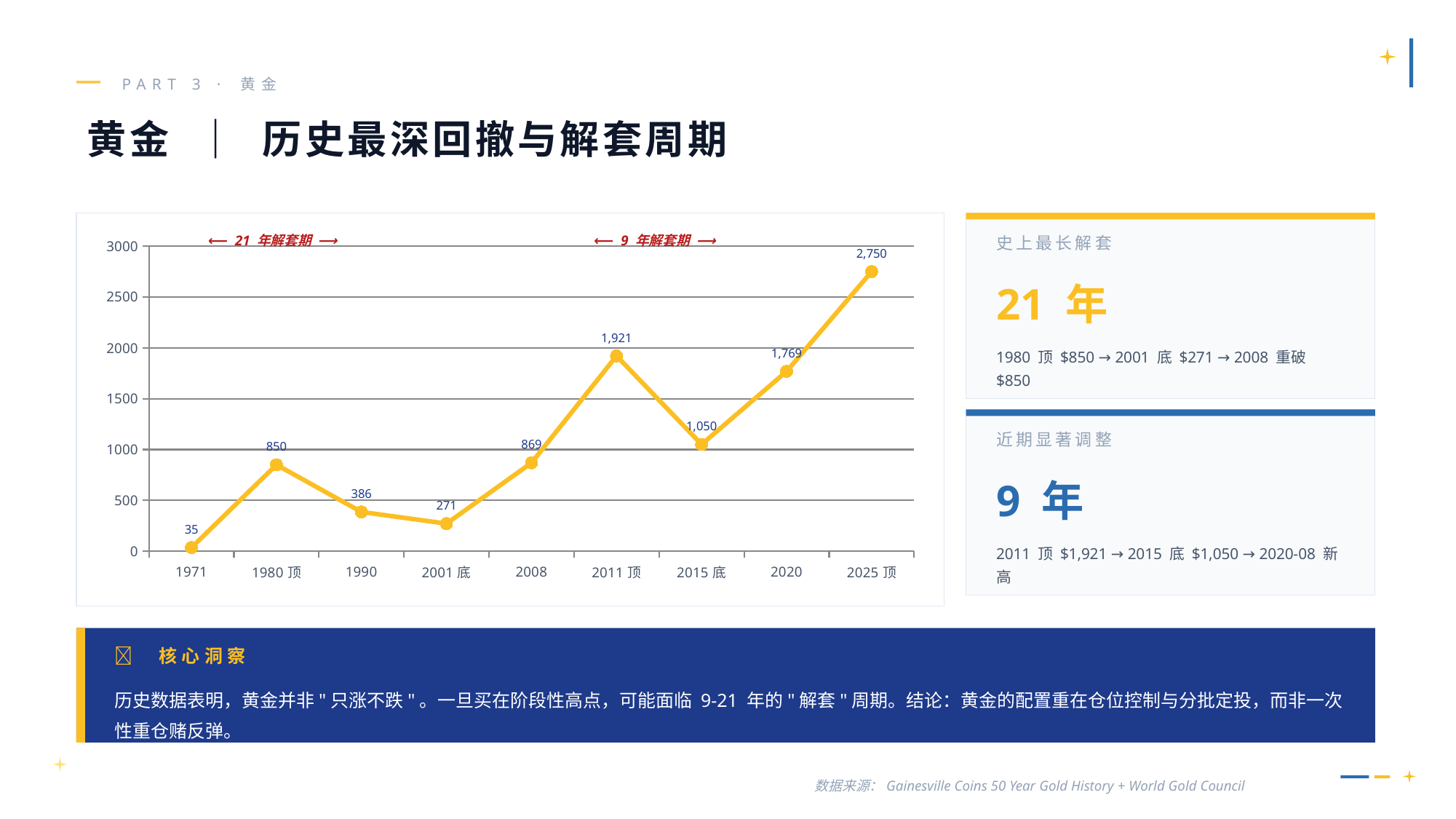
What is the value plotted for 2011 顶? 1,921 How many data points are plotted on the line chart? 9 Which category has the lowest value on the chart? 1971 Is the value for 2020 greater or less than 1500? greater What is the difference between the values for 2011 顶 and 2015 底? 871 Does the value rise or fall from 2015 底 to 2025 顶? rise What is the difference between the values for 1980 顶 and 2001 底? 579 What kind of chart is shown on the slide? line chart Which category has the highest value on the chart? 2025 顶 What is the value plotted for 1971? 35 Which is larger, the value for 2008 or the value for 1990? 2008 What is the value plotted for 2015 底? 1,050